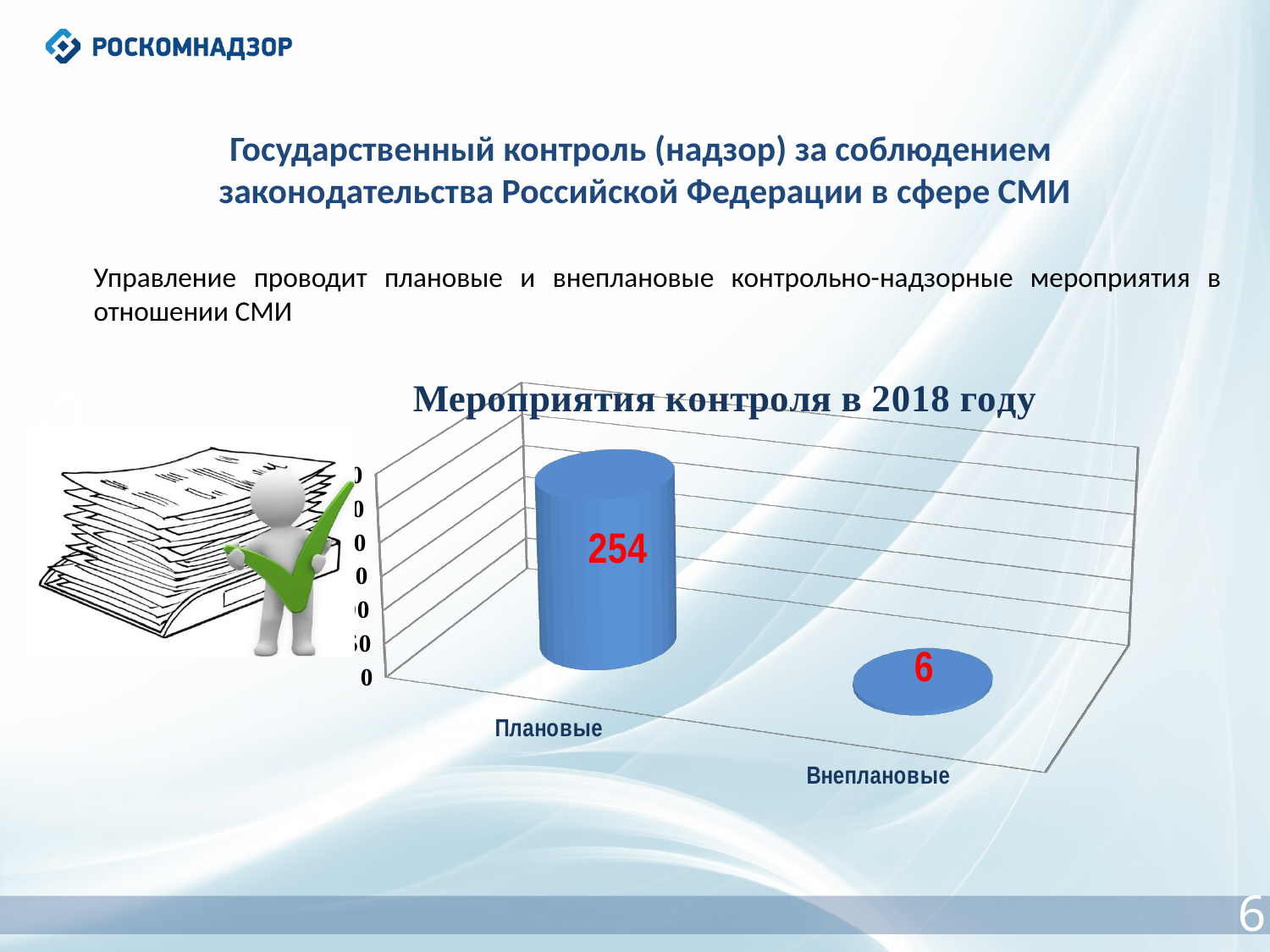
How many categories are shown in the chart? 2 Which category has the lowest value in the chart? Внеплановые What colour are the bars in the chart? Blue What is the total of the two values shown in the chart? 260 Which is larger, the value for Плановые or the value for Внеплановые? Плановые Which category has the highest value in the chart? Плановые What is the value for Плановые in the chart? 254 What is the difference between the values for Плановые and Внеплановые? 248 What is the title of the chart? Мероприятия контроля в 2018 году What is the value for Внеплановые in the chart? 6 What kind of chart is shown on the slide? Bar chart